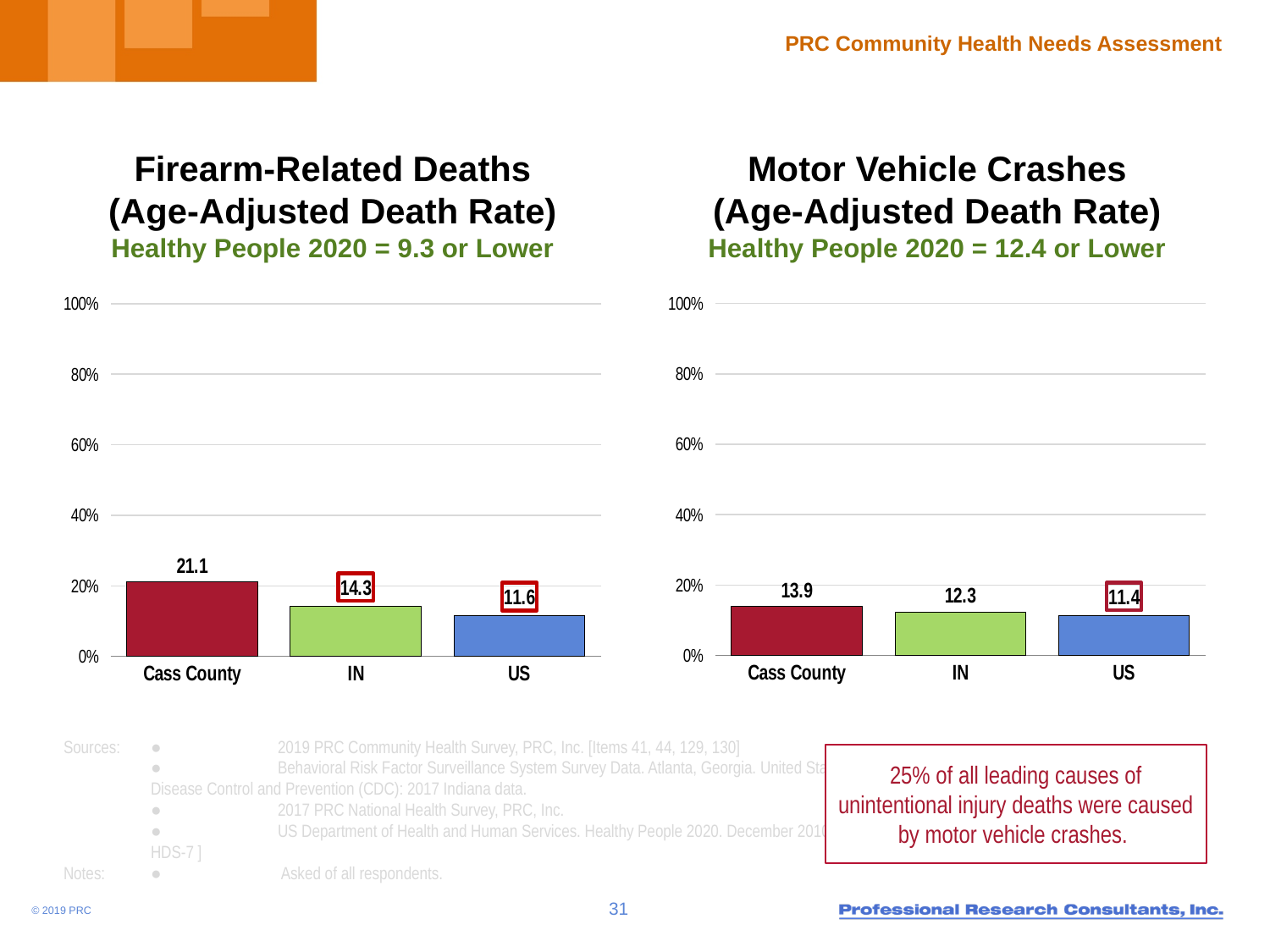
In the Motor Vehicle Crashes chart, what is the value for Cass County? 13.9 In the Firearm-Related Deaths chart, what is the difference between the Cass County value and the US value? 9.5 What Healthy People 2020 target is stated in the subtitle of the Motor Vehicle Crashes chart? 12.4 or Lower In the Firearm-Related Deaths chart, which category has the highest value? Cass County In the Motor Vehicle Crashes chart, what is the difference between the Cass County value and the IN value? 1.6 In the Firearm-Related Deaths chart, which is larger, the value for IN or the value for US? IN In the Motor Vehicle Crashes chart, which category has the lowest value? US How many categories are shown in the Motor Vehicle Crashes chart? 3 In the Firearm-Related Deaths chart, what is the value for Cass County? 21.1 In the Motor Vehicle Crashes chart, what is the value for US? 11.4 What kind of chart is the Firearm-Related Deaths chart? Bar chart In the Firearm-Related Deaths chart, what is the value for IN? 14.3